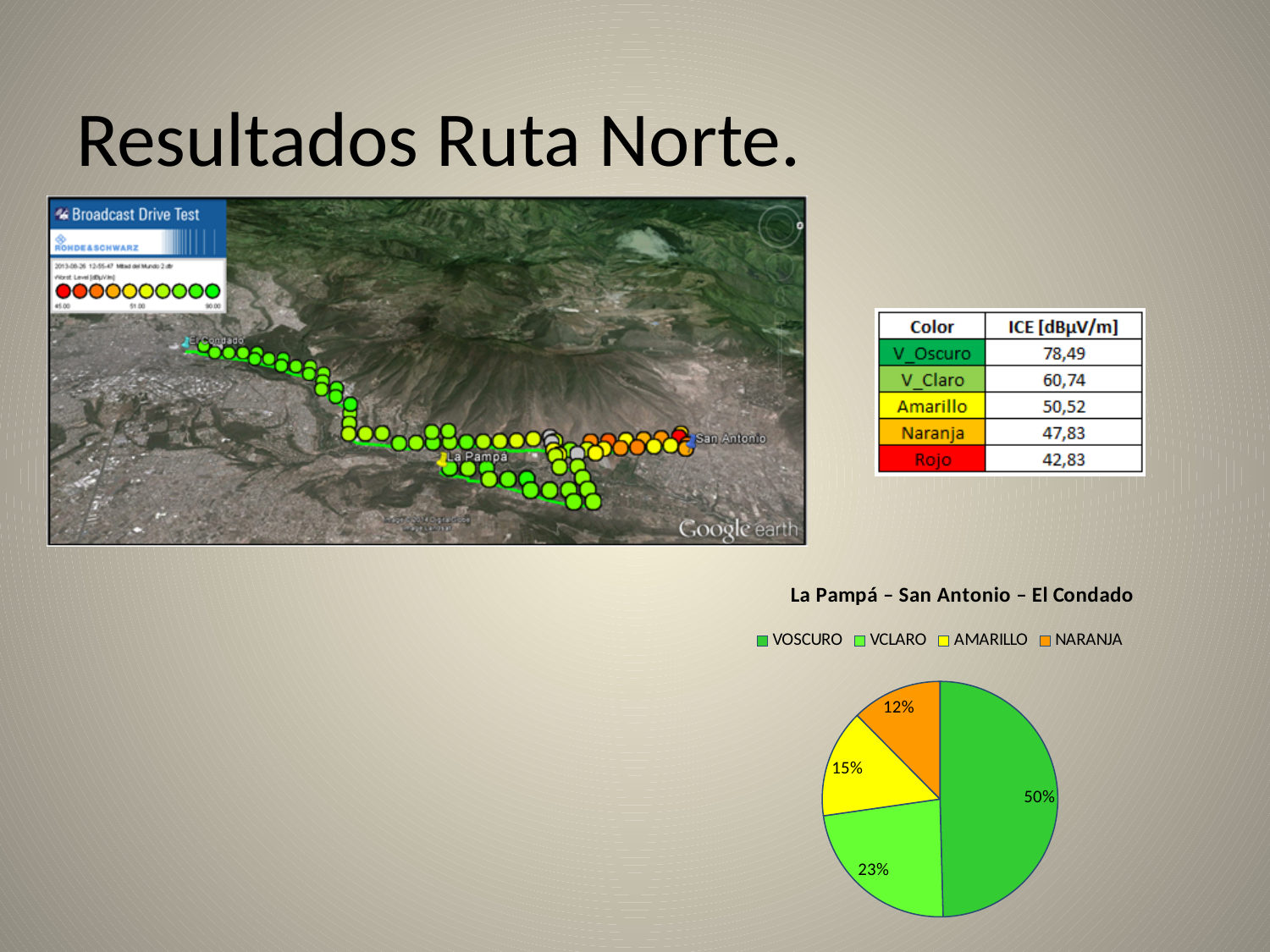
What share of the pie chart does AMARILLO represent? 15% What is the title of the pie chart? La Pampá – San Antonio – El Condado Which category has the largest slice in the pie chart? VOSCURO What share of the pie chart does VCLARO represent? 23% What type of chart is shown on the slide? pie chart What colour is the VOSCURO slice in the pie chart? dark green Which slice is larger in the pie chart, AMARILLO or NARANJA? AMARILLO What share of the pie chart does VOSCURO represent? 50% What is the difference in percentage points between the VOSCURO and VCLARO slices? 27 How many categories does the pie chart legend list? 4 Which category has the smallest slice in the pie chart? NARANJA